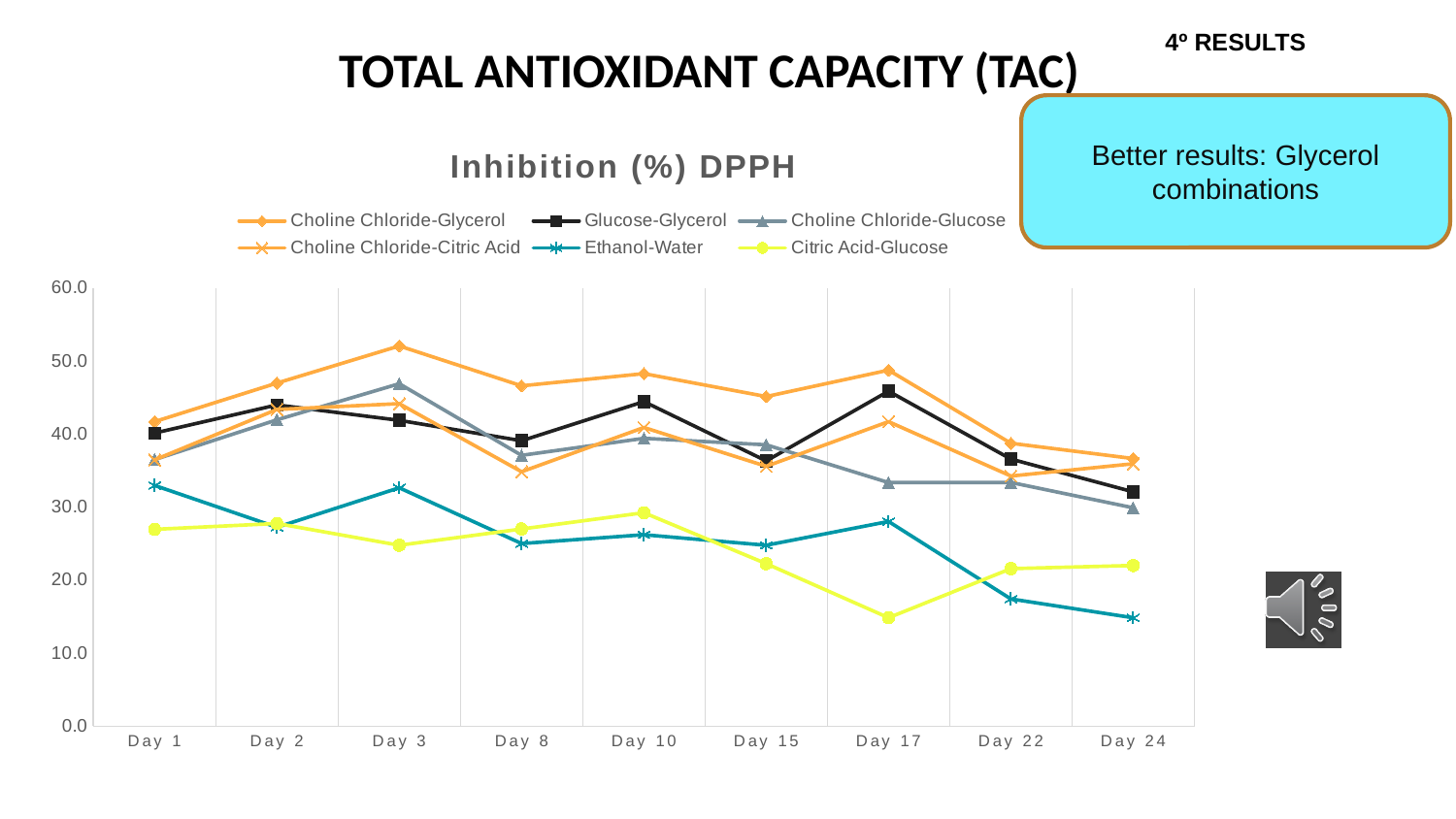
On which day does Choline Chloride-Glycerol reach its highest value? Day 3 How many series does the legend list? 6 Does the Ethanol-Water series rise or fall from Day 17 to Day 24? fall Is the value for Citric Acid-Glucose on Day 17 greater or less than 20.0? less Is the value for Choline Chloride-Glycerol on Day 3 greater or less than 50.0? greater Is the value for Ethanol-Water on Day 24 greater or less than 20.0? less What kind of chart is shown on the slide? line chart What is the title of the chart? Inhibition (%) DPPH How many days are shown along the x axis? 9 Which series has the highest value on Day 3? Choline Chloride-Glycerol Which series has the lowest value on Day 17? Citric Acid-Glucose On Day 24, which is larger: Glucose-Glycerol or Choline Chloride-Glucose? Glucose-Glycerol